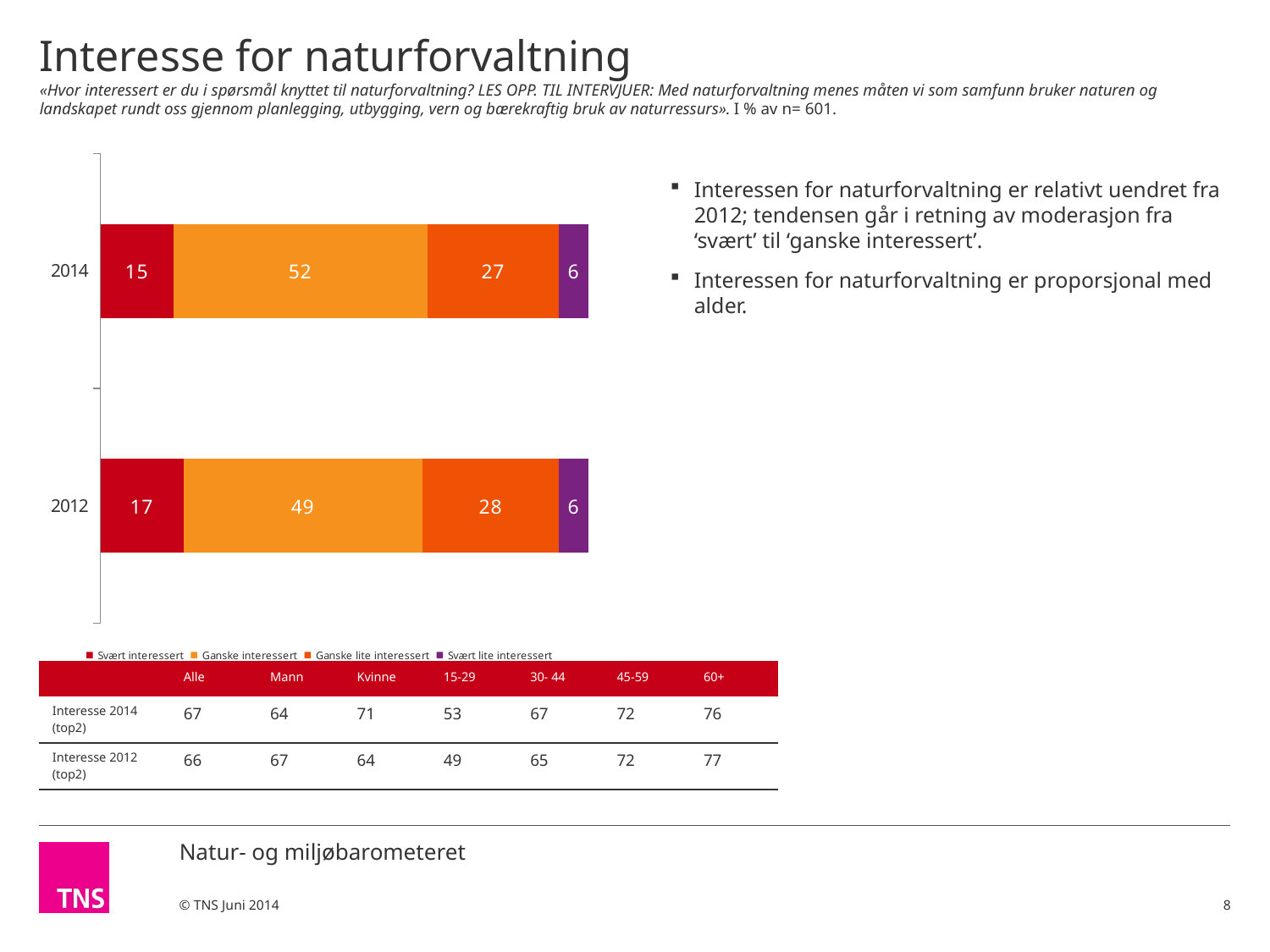
What kind of chart is shown on the slide? stacked bar chart What is the value for 'Svært interessert' in 2012? 17 Which series has the largest value in the 2014 bar? Ganske interessert How many series does the chart legend list? 4 What is the value for 'Ganske interessert' in 2014? 52 What is the total of the stacked bar for 2014? 100 Is the 'Svært interessert' value larger in 2014 or in 2012? 2012 What is the value for 'Ganske lite interessert' in 2014? 27 How many categories (years) are plotted in the chart? 2 Which series has the smallest value in the 2012 bar? Svært lite interessert What is the difference between the 'Ganske interessert' values for 2014 and 2012? 3 What is the value for 'Svært lite interessert' in 2012? 6